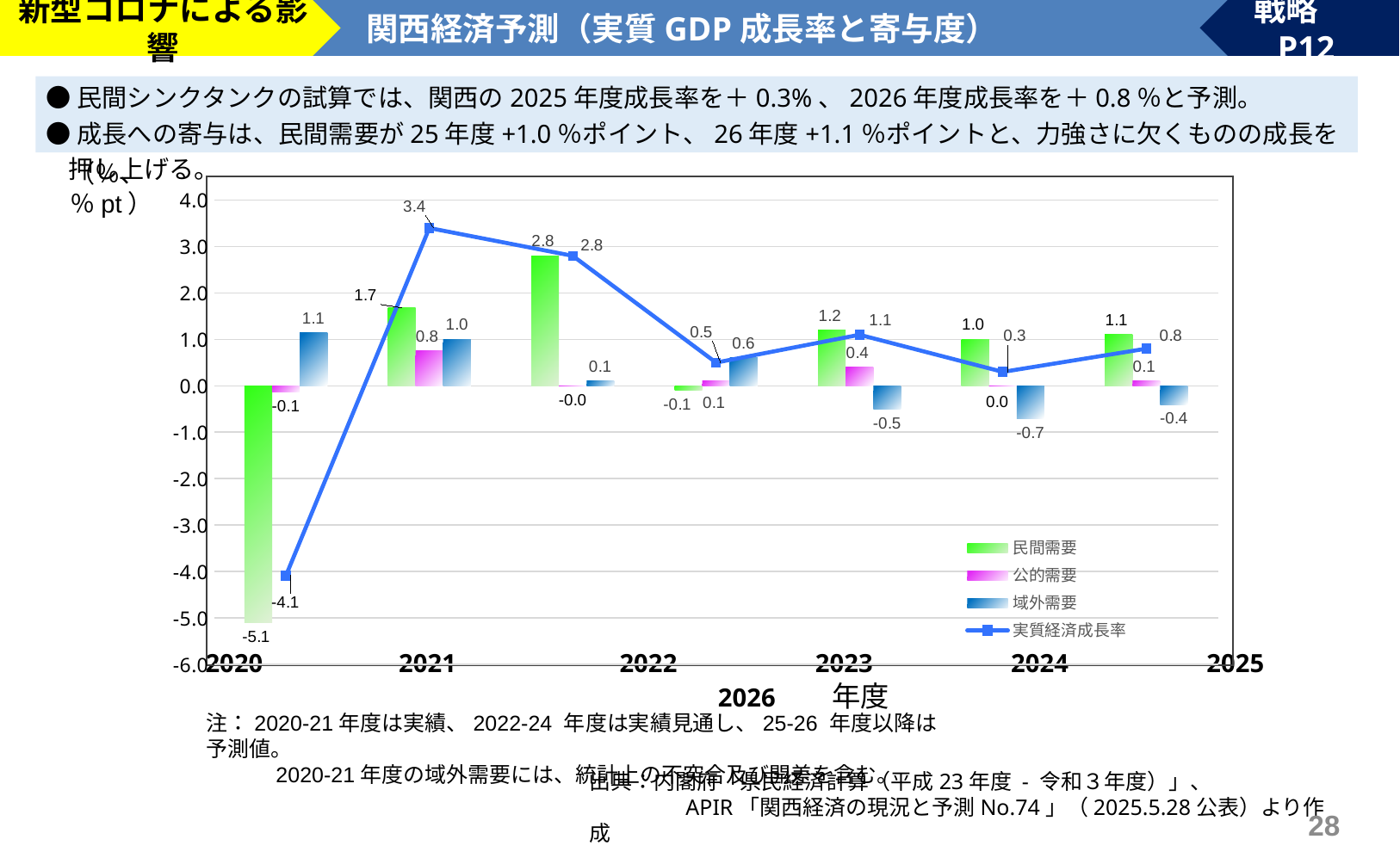
What is the highest value among the 民間需要 bars? 2.8 How many series does the chart legend list? 4 What is the value of 実質経済成長率 for 2021? 3.4 What is the lowest value among the 民間需要 bars? -5.1 Which series is drawn as a line rather than bars? 実質経済成長率 What is the highest value of the 実質経済成長率 line? 3.4 What is the difference between 民間需要 (1.7) and 域外需要 (1.0) in 2021? 0.7 How many year groups of bars are plotted in the chart? 7 What is the lowest value of the 実質経済成長率 line? -4.1 What kind of chart is shown on the slide? A combined bar and line chart What is the value of 域外需要 for 2020? 1.1 In 2020, which is larger: 民間需要 or 域外需要? 域外需要